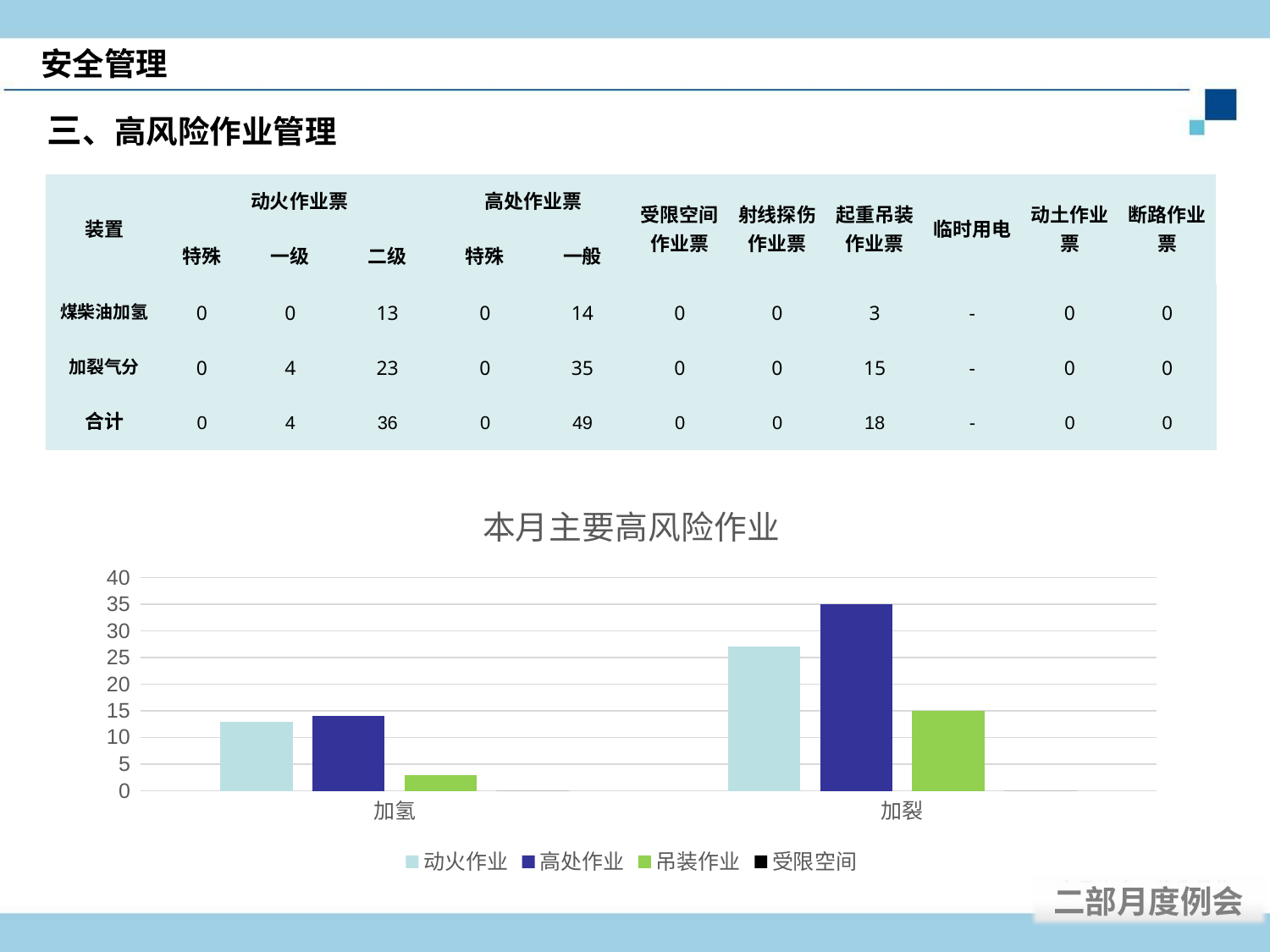
What kind of chart is shown under the title 本月主要高风险作业? bar chart In the chart, which category has the larger 动火作业 value, 加氢 or 加裂? 加裂 How many series does the chart legend list? 4 In the chart, is the value of 动火作业 for 加裂 greater or less than 25? greater What is the title of the chart on the slide? 本月主要高风险作业 In the chart, what is the value of 受限空间 for 加氢? 0 In the chart, is the value of 吊装作业 for 加氢 greater or less than 5? less In the chart, what is the value of 高处作业 for 加裂? 35 How many categories are shown on the x axis of the chart? 2 In the chart, which series has the lowest value for 加氢? 受限空间 In the chart, what is the value of 吊装作业 for 加裂? 15 In the chart, which series has the highest value for 加裂? 高处作业